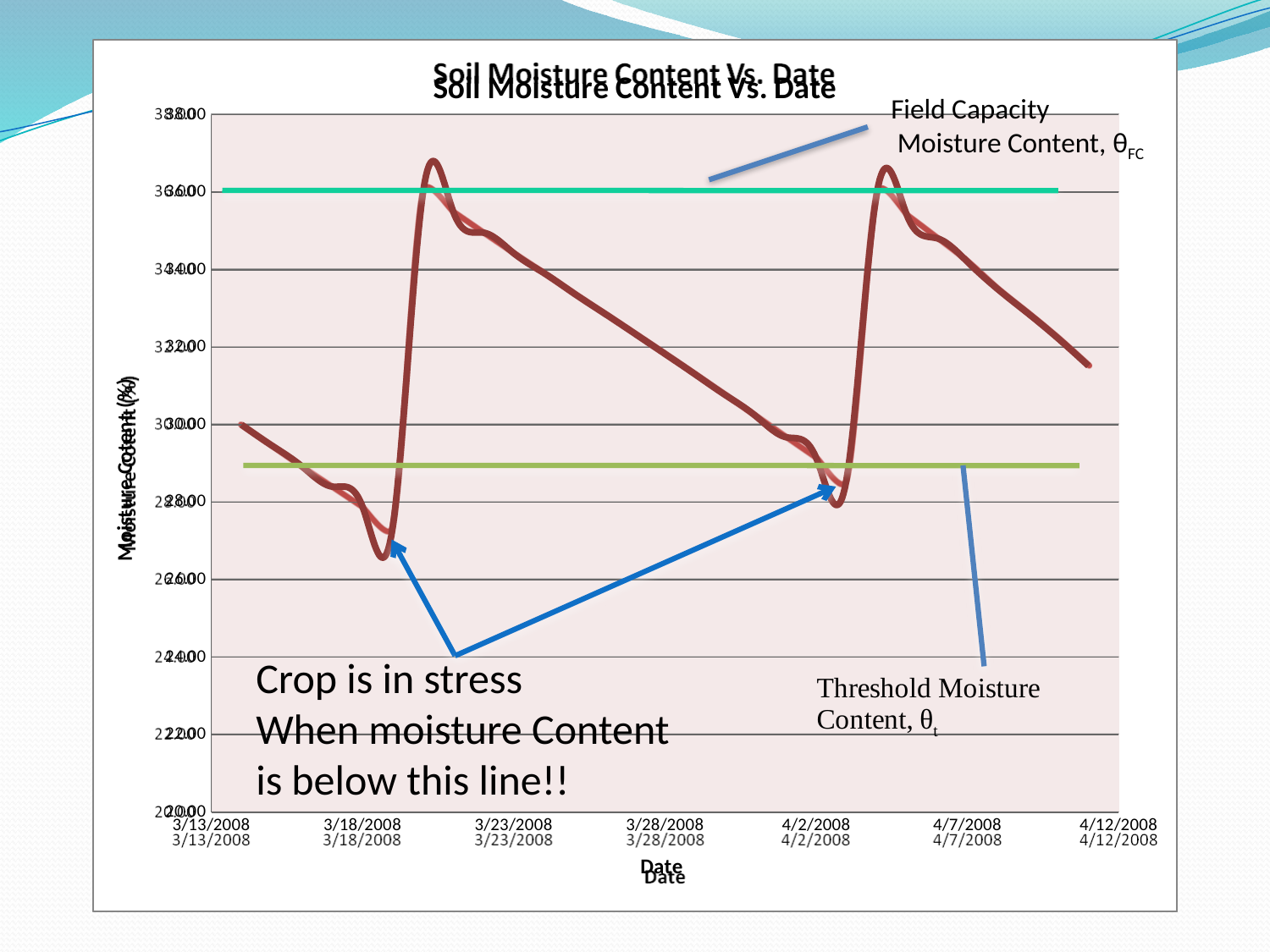
What is the first date shown on the x axis? 3/13/2008 What label is given to the upper horizontal green line on the chart? Field Capacity Moisture Content, θFC Is the soil moisture content higher on 3/23/2008 or on 4/2/2008? 3/23/2008 What kind of chart is shown on the slide? line chart What is the last date shown on the x axis? 4/12/2008 Does the soil moisture content rise or fall between 3/23/2008 and 3/28/2008? fall Does the soil moisture content rise or fall between 3/13/2008 and 3/18/2008? fall Does the soil moisture content rise or fall between 4/7/2008 and 4/12/2008? fall Which horizontal reference line sits higher on the chart, the Field Capacity line or the Threshold Moisture Content line? Field Capacity What is the title of the chart? Soil Moisture Content Vs. Date How many date ticks are shown along the x axis? 7